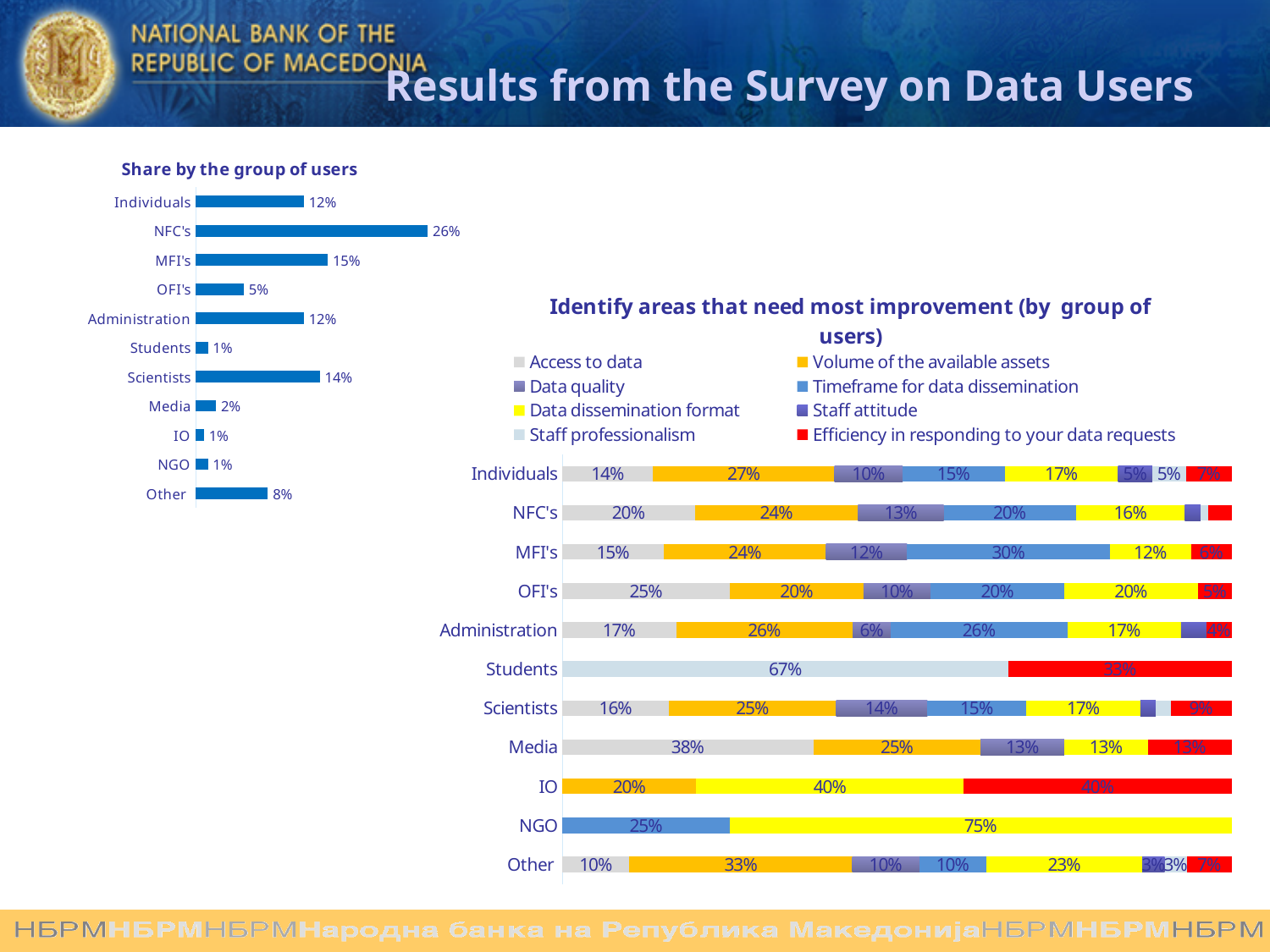
What is the title of the chart on the left of the slide? Share by the group of users In the 'Identify areas that need most improvement' chart, what is the value of 'Volume of the available assets' for Individuals? 27% In the 'Identify areas that need most improvement' chart, what is the total of the Students bar? 100% How many series does the legend of the 'Identify areas that need most improvement' chart list? 8 In the 'Share by the group of users' chart, which group has the highest share? NFC's In the 'Identify areas that need most improvement' chart, what is the value of 'Data dissemination format' for NGO? 75% In the 'Share by the group of users' chart, which is larger, the share for Scientists or for Administration? Scientists In the 'Share by the group of users' chart, what is the difference between the shares of NFC's and MFI's? 11 percentage points In the 'Share by the group of users' chart, what is the value for NFC's? 26% In the 'Identify areas that need most improvement' chart, what is the value of 'Timeframe for data dissemination' for MFI's? 30% How many groups of users are shown in the 'Share by the group of users' chart? 11 What kind of chart is the 'Share by the group of users' chart? Bar chart